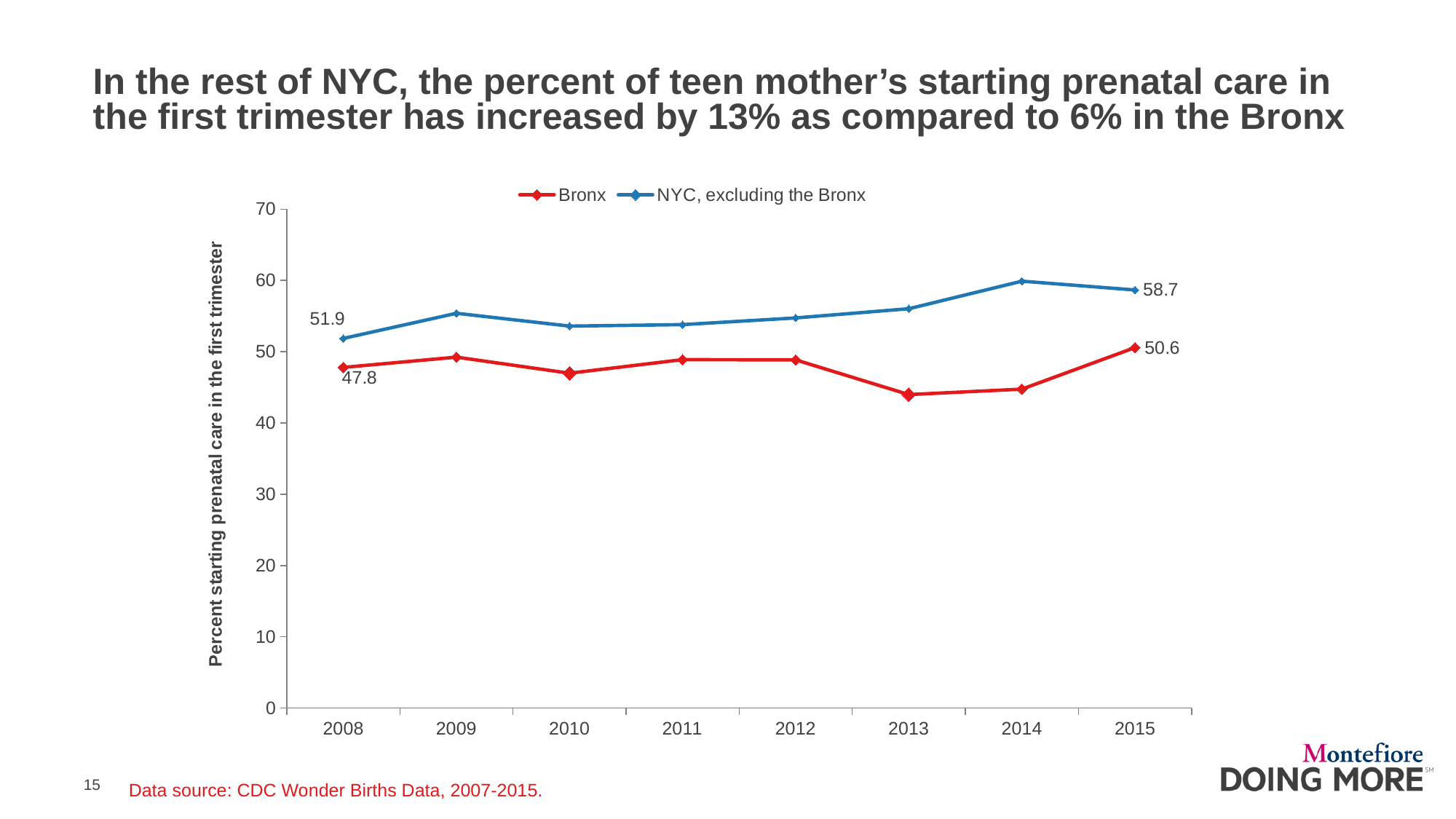
What is the value for Bronx in 2015? 50.6 What is the value for Bronx in 2008? 47.8 How many years are shown on the x axis? 8 What is the difference between the NYC, excluding the Bronx value and the Bronx value in 2015? 8.1 Is the value for Bronx in 2013 greater or less than 50? less Is the value for NYC, excluding the Bronx in 2014 greater or less than 50? greater What kind of chart is shown on the slide? Line chart How many series does the legend list? 2 What is the value for NYC, excluding the Bronx in 2015? 58.7 Which series has the higher value in 2013, Bronx or NYC, excluding the Bronx? NYC, excluding the Bronx What is the value for NYC, excluding the Bronx in 2008? 51.9 What is the difference between the Bronx value in 2015 and in 2008? 2.8